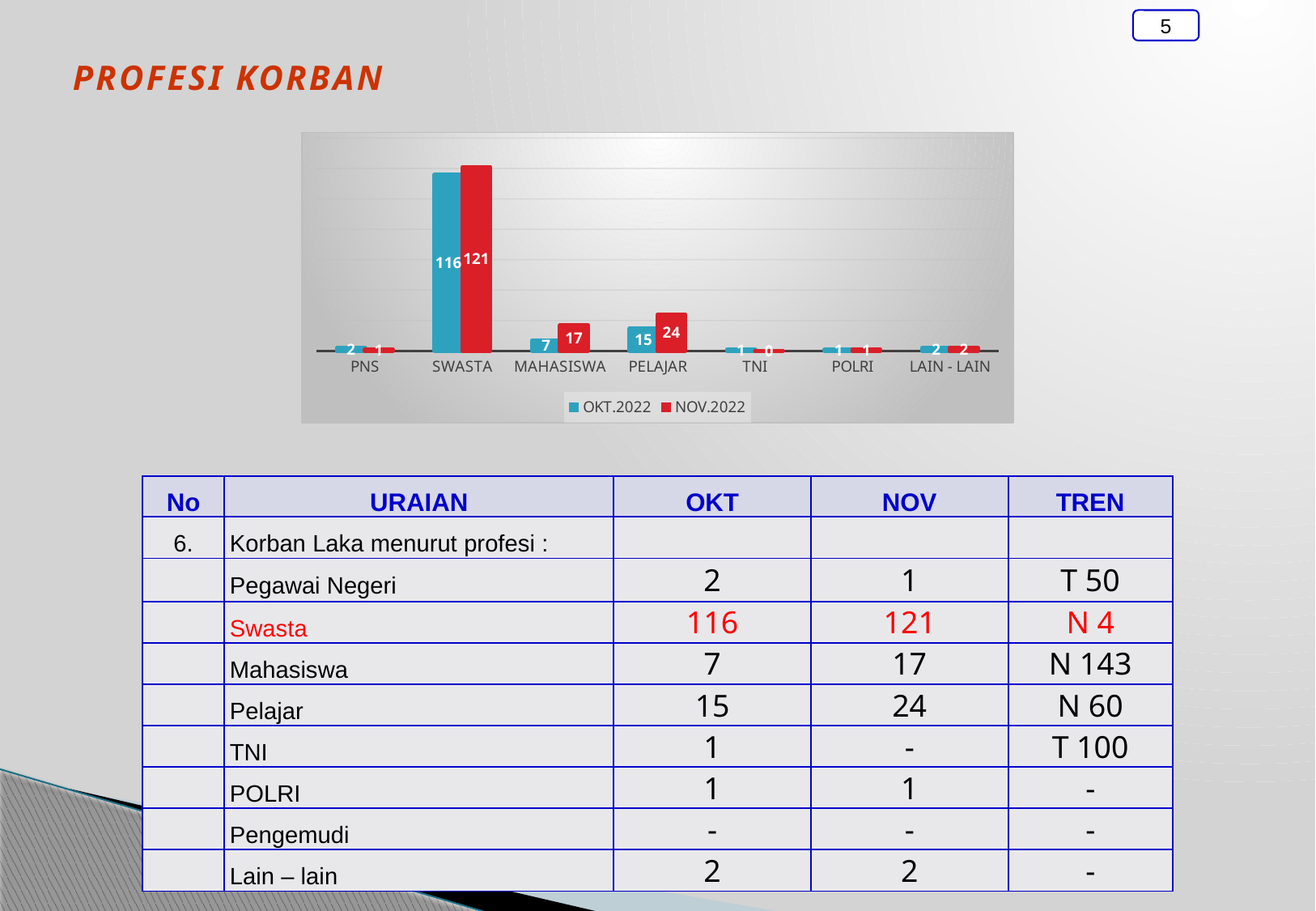
What is the OKT.2022 value for SWASTA in the chart? 116 What is the NOV.2022 value for PELAJAR in the chart? 24 What kind of chart is shown on the slide? bar chart What is the NOV.2022 value for MAHASISWA in the chart? 17 What is the difference between the NOV.2022 and OKT.2022 values for SWASTA? 5 Which colour represents the NOV.2022 series in the chart? red How many series does the chart legend list? 2 Which category has the highest NOV.2022 value in the chart? SWASTA What is the difference between the NOV.2022 and OKT.2022 values for MAHASISWA? 10 How many categories are shown on the x axis of the chart? 7 Which is larger for PELAJAR: the OKT.2022 value or the NOV.2022 value? NOV.2022 Which category has the lowest NOV.2022 value in the chart? TNI